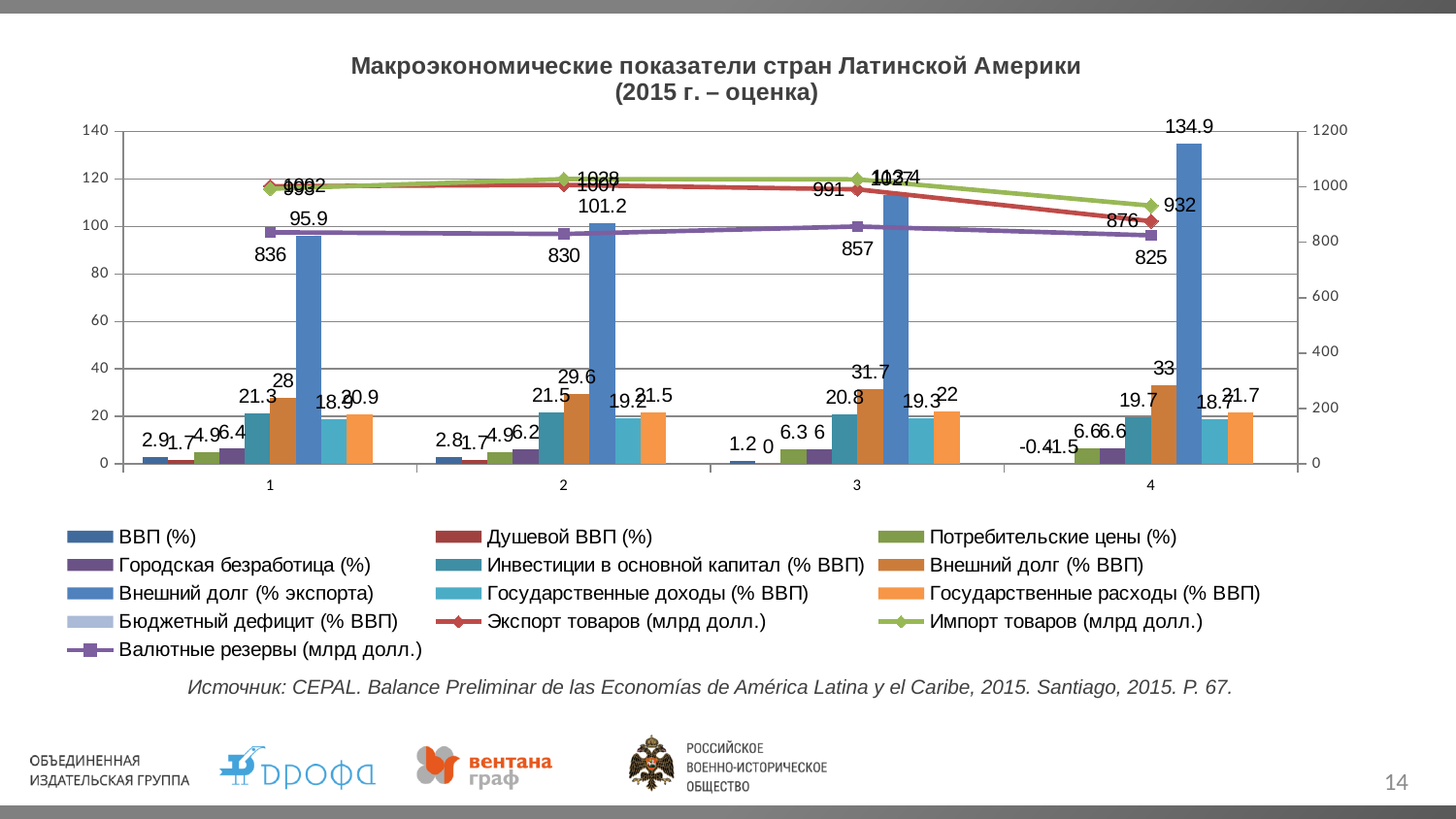
What is the value of Экспорт товаров (млрд долл.) for category 4? 876 For which category is Валютные резервы (млрд долл.) the lowest? 4 What is the value of Валютные резервы (млрд долл.) for category 3? 857 What is the difference between Внешний долг (% экспорта) for category 4 and category 1? 39 How many series does the legend list? 13 For category 4, which is larger: Импорт товаров (млрд долл.) or Экспорт товаров (млрд долл.)? Импорт товаров (млрд долл.) What is the value of Внешний долг (% экспорта) for category 4? 134.9 What is the value of ВВП (%) for category 4? -0.4 How many categories are shown on the x axis? 4 For which category is Внешний долг (% экспорта) the highest? 4 Does Внешний долг (% экспорта) rise or fall from category 1 to category 4? Rises What type of chart is shown on the slide? Combined bar and line chart